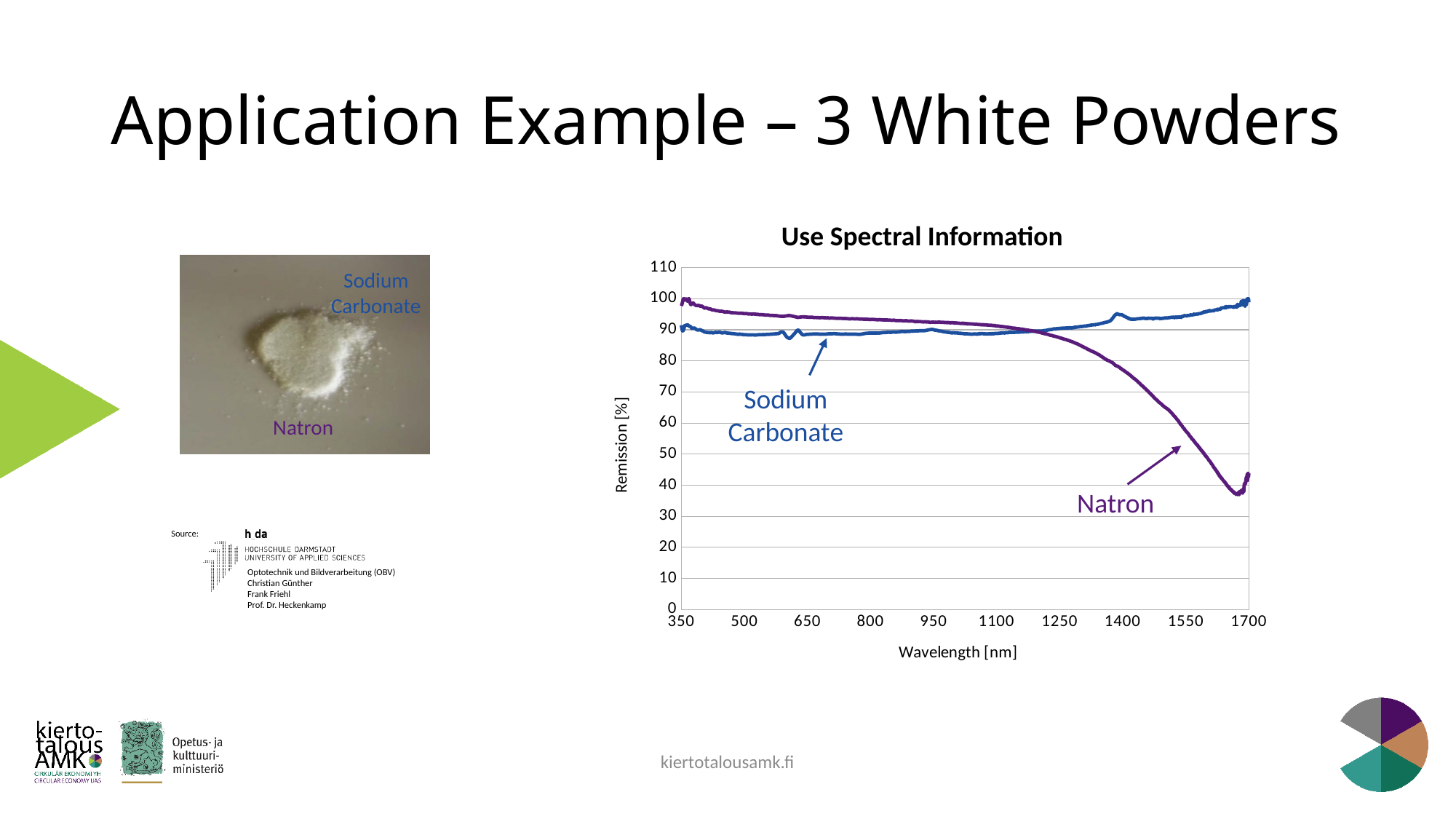
What is the label of the y axis of the chart? Remission [%] Is the remission value for Natron at 1250 nm greater or less than 90? less How many series are plotted in the "Use Spectral Information" chart? 2 Which series reaches the lowest remission value anywhere on the chart? Natron What is the title of the chart on the slide? Use Spectral Information At 500 nm, which series has the higher remission, Sodium Carbonate or Natron? Natron Is the remission value for Natron at 350 nm greater or less than 90? greater Is the remission value for Natron at 1700 nm greater or less than 50? less At 1550 nm, which series has the higher remission, Sodium Carbonate or Natron? Sodium Carbonate Does the remission of Natron rise or fall as wavelength increases from 1100 nm to 1650 nm? fall What kind of chart is shown under the title "Use Spectral Information"? Line chart